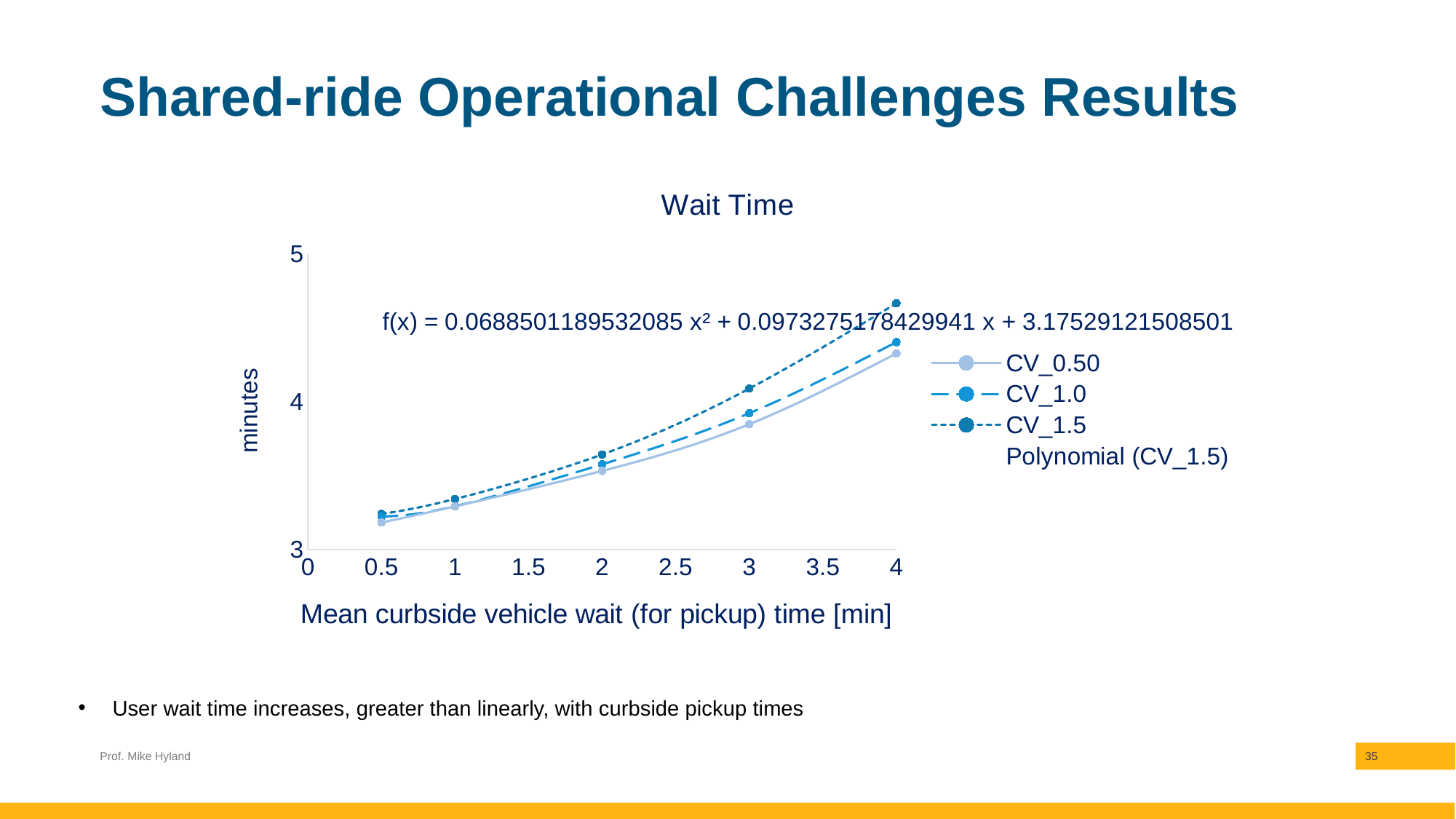
What is the title of the chart? Wait Time At x = 4, is the value for CV_1.5 greater or less than 5? less How many entries does the chart legend list? 4 Which series has the lowest value at x = 4? CV_0.50 Which series has the highest value at x = 4? CV_1.5 Do the wait time values rise or fall as the mean curbside vehicle wait time increases along the x axis? rise At x = 0.5, is the value for CV_0.50 greater or less than 4? less At x = 4, is the value for CV_1.5 greater or less than 4? greater What is the label of the x axis? Mean curbside vehicle wait (for pickup) time [min] How many data points are plotted for the CV_0.50 series? 5 What type of chart is shown on the slide? line chart At x = 4, which is larger, the value for CV_1.5 or the value for CV_0.50? CV_1.5